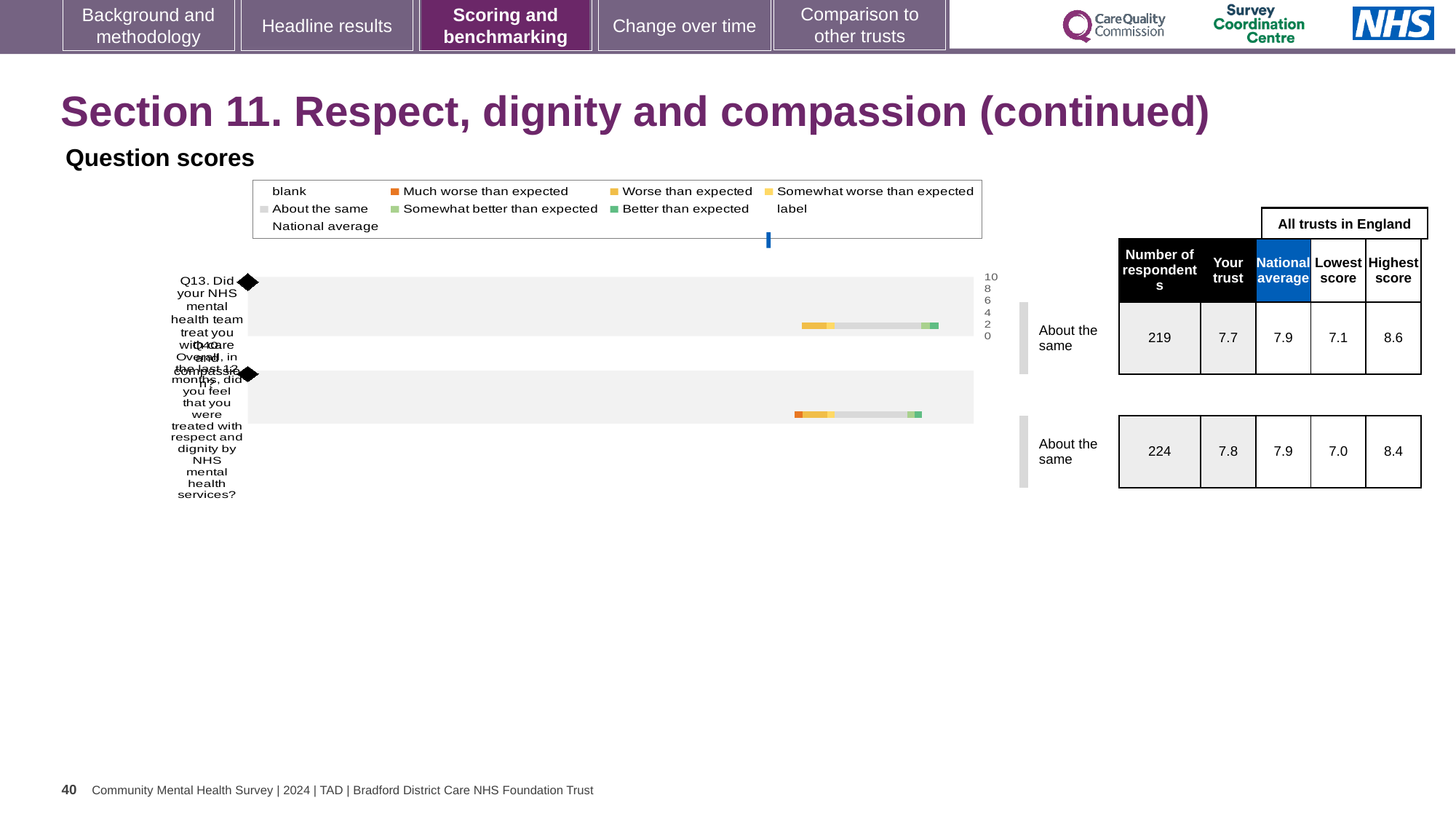
What kind of chart is used to show the question scores on this slide? bar chart What is the difference between the highest and lowest scores for Q13? 1.5 What is the lowest score among all trusts in England for Q13? 7.1 How many questions are plotted in the question scores chart? 2 What is the national average score for Q13? 7.9 How many respondents are listed for Q40? 224 What is the highest score among all trusts in England for Q40? 8.4 What is the 'Your trust' score for Q40? 7.8 How many respondents are listed for Q13? 219 What is the 'Your trust' score for Q13? 7.7 Which question has more respondents, Q13 or Q40? Q40 What benchmark category is shown next to the Q13 bar? About the same